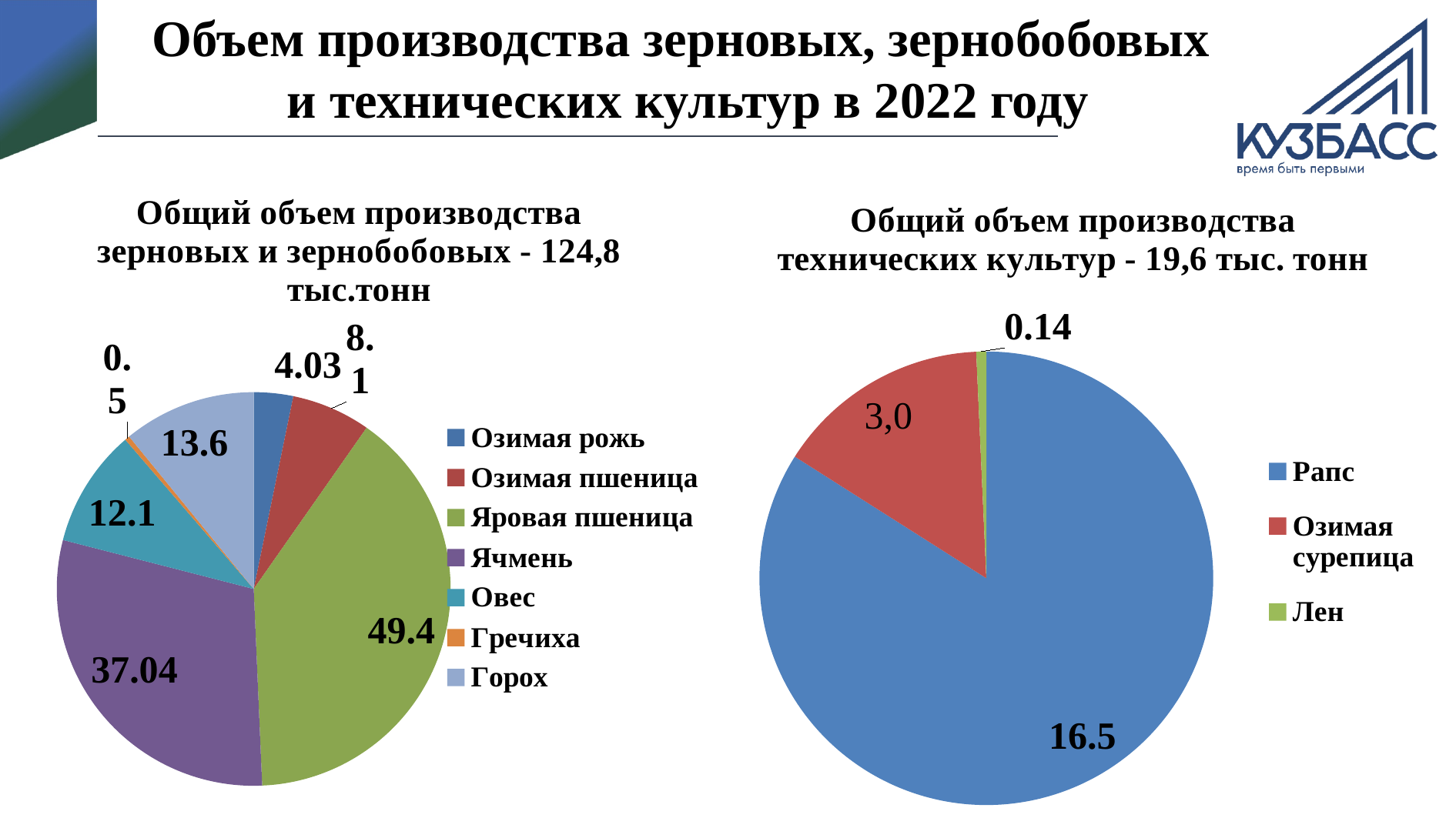
In the left pie chart (зерновых и зернобобовых), what is the value for Горох? 13.6 In the right pie chart (технических культур), which category has the smallest slice? Лен In the right pie chart (технических культур), what is the value for Лен? 0.14 How many categories does the legend of the left pie chart (зерновых и зернобобовых) list? 7 In the left pie chart (зерновых и зернобобовых), which category has the largest slice? Яровая пшеница In the left pie chart (зерновых и зернобобовых), what is the value for Яровая пшеница? 49.4 In the right pie chart (технических культур), what is the value for Рапс? 16.5 In the left pie chart (зерновых и зернобобовых), what is the difference between the values for Яровая пшеница and Ячмень? 12.36 In the left pie chart (зерновых и зернобобовых), what is the value for Ячмень? 37.04 What type of chart is used on the right side of the slide (технических культур)? Pie chart In the left pie chart (зерновых и зернобобовых), which is larger: Овес or Горох? Горох In the left pie chart (зерновых и зернобобовых), which category has the smallest slice? Гречиха